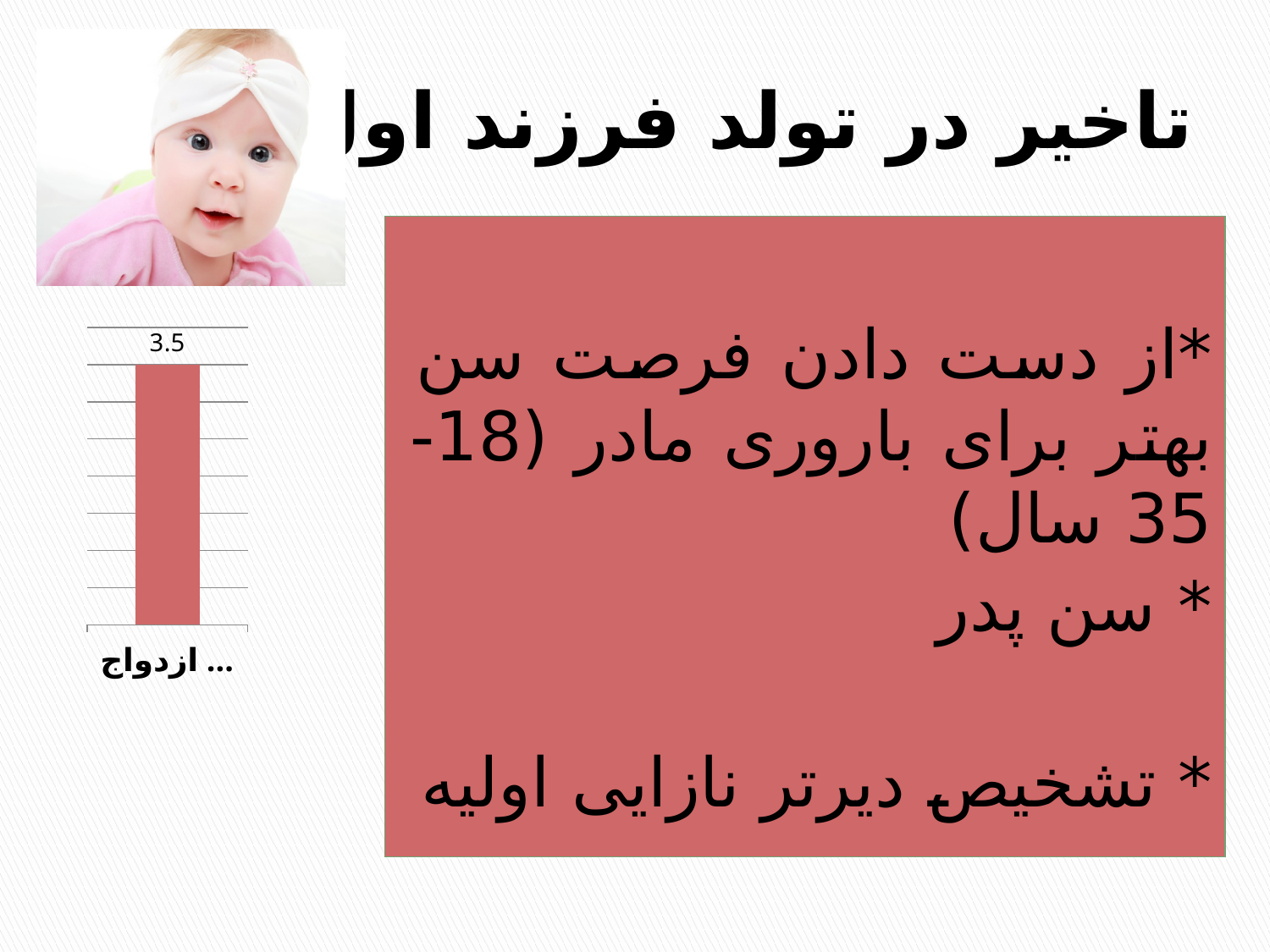
Is the bar in the chart on the left of the slide vertical or horizontal? vertical What kind of chart is shown on the left of the slide? bar chart What value is printed above the bar in the chart on the left of the slide? 3.5 How many bars does the chart on the left of the slide contain? 1 What is the value of the bar labelled '... ازدواج' in the chart on the left of the slide? 3.5 What colour is the bar in the chart on the left of the slide? pink/red